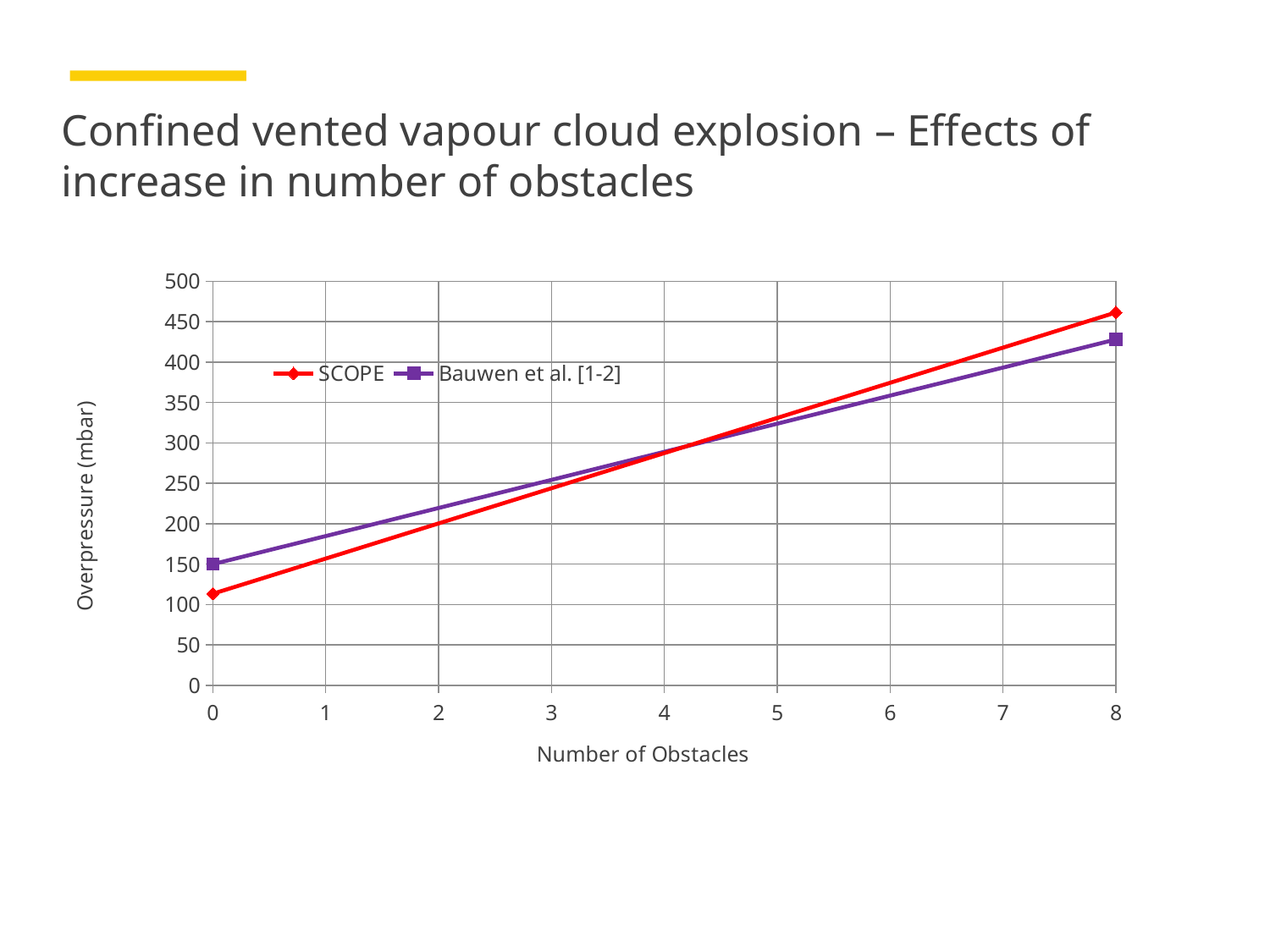
Does the Bauwen et al. [1-2] series rise or fall as the number of obstacles increases? rise Is the Bauwen et al. [1-2] value at 8 obstacles greater or less than 400? greater Is the SCOPE value at 8 obstacles greater or less than 400? greater At 0 obstacles, which series has the higher overpressure, SCOPE or Bauwen et al. [1-2]? Bauwen et al. [1-2] Is the SCOPE value at 0 obstacles greater or less than 150? less At 8 obstacles, which series has the higher overpressure, SCOPE or Bauwen et al. [1-2]? SCOPE What is the label of the y axis? Overpressure (mbar) What kind of chart is shown on the slide? line chart Does the SCOPE series rise or fall as the number of obstacles increases? rise How many series does the legend list? 2 What are the two series named in the legend? SCOPE and Bauwen et al. [1-2]